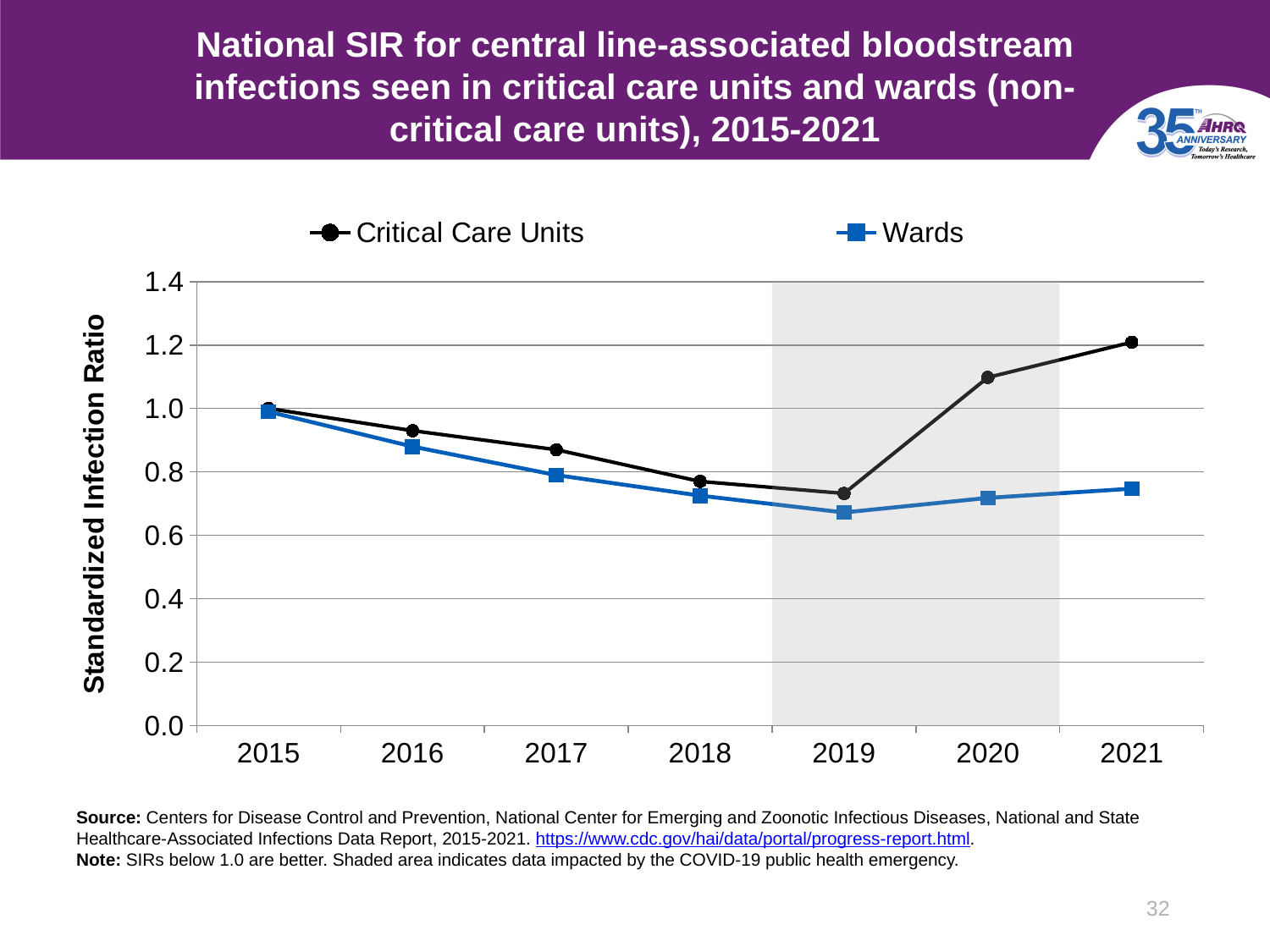
In which year is the Wards value highest? 2015 According to the note, what does the shaded area indicate? Data impacted by the COVID-19 public health emergency Is the Wards value for 2021 greater or less than 1.0? less In 2020, which series has the larger value, Critical Care Units or Wards? Critical Care Units How many series does the legend list? 2 What kind of chart is shown on the slide? Line chart Is the Wards value for 2019 greater or less than 0.8? less Is the Critical Care Units value for 2021 greater or less than 1.0? greater In which year is the Critical Care Units value highest? 2021 How many years are plotted along the x axis? 7 Do the Critical Care Units values rise or fall from 2015 to 2019? Fall In which year is the Wards value lowest? 2019